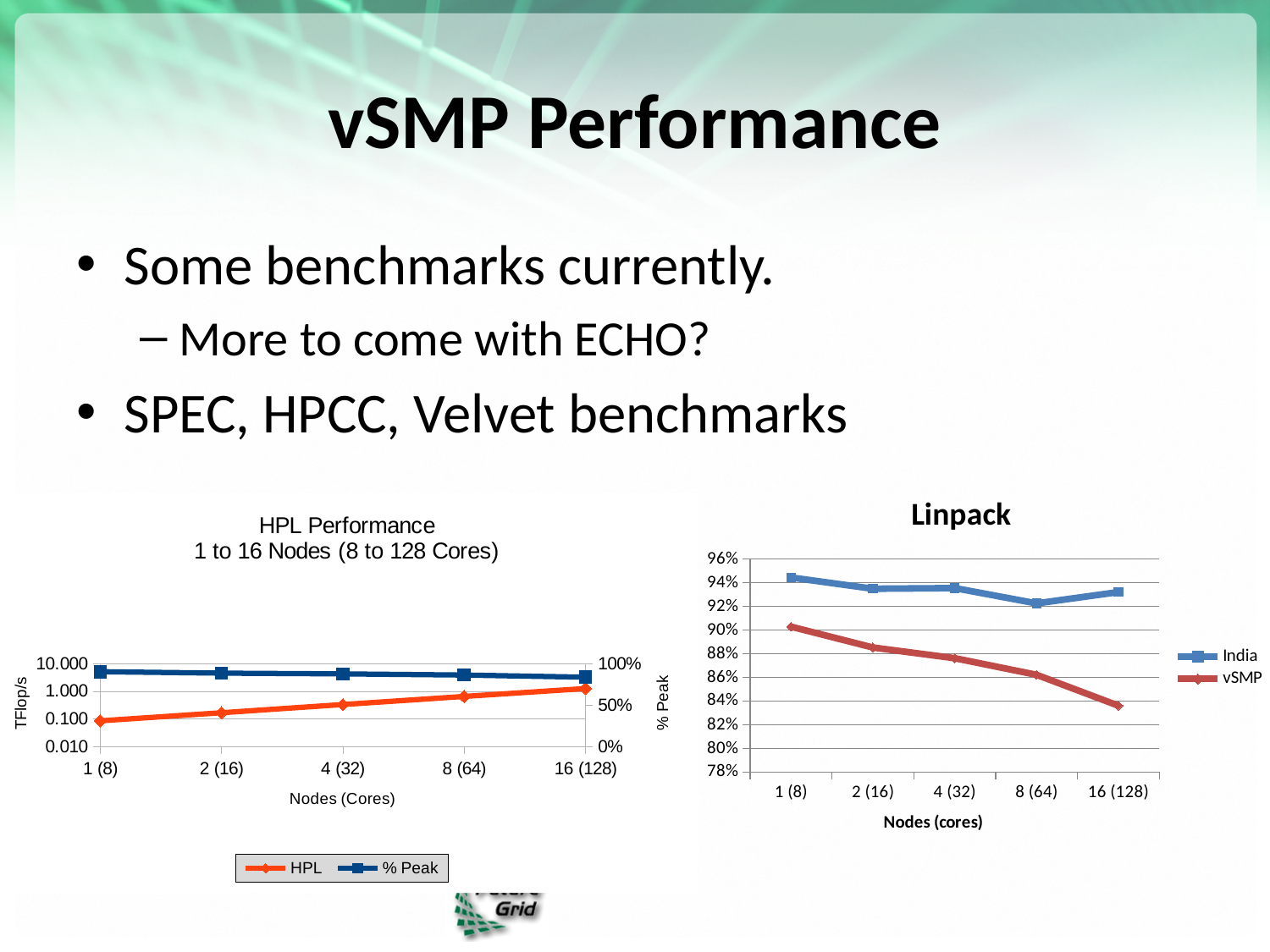
In the HPL Performance chart, is the HPL value at 4 (32) greater or less than 0.100 TFlop/s? greater In the Linpack chart, does the vSMP series rise or fall as the number of nodes increases? fall How many points are plotted along the x axis of the Linpack chart for the vSMP series? 5 In the Linpack chart, at which node count is the vSMP value lowest? 16 (128) What is the x-axis title of the HPL Performance chart? Nodes (Cores) What kind of chart is the Linpack chart? line chart How many series does the legend of the Linpack chart list? 2 In the Linpack chart, is the vSMP value at 16 (128) greater or less than 86%? less In the HPL Performance chart, does the HPL series rise or fall as the number of nodes increases? rise In the Linpack chart, which series has the larger value at 16 (128), India or vSMP? India In the Linpack chart, is the India value at 1 (8) greater or less than 92%? greater In the Linpack chart, at which node count is the India value highest? 1 (8)